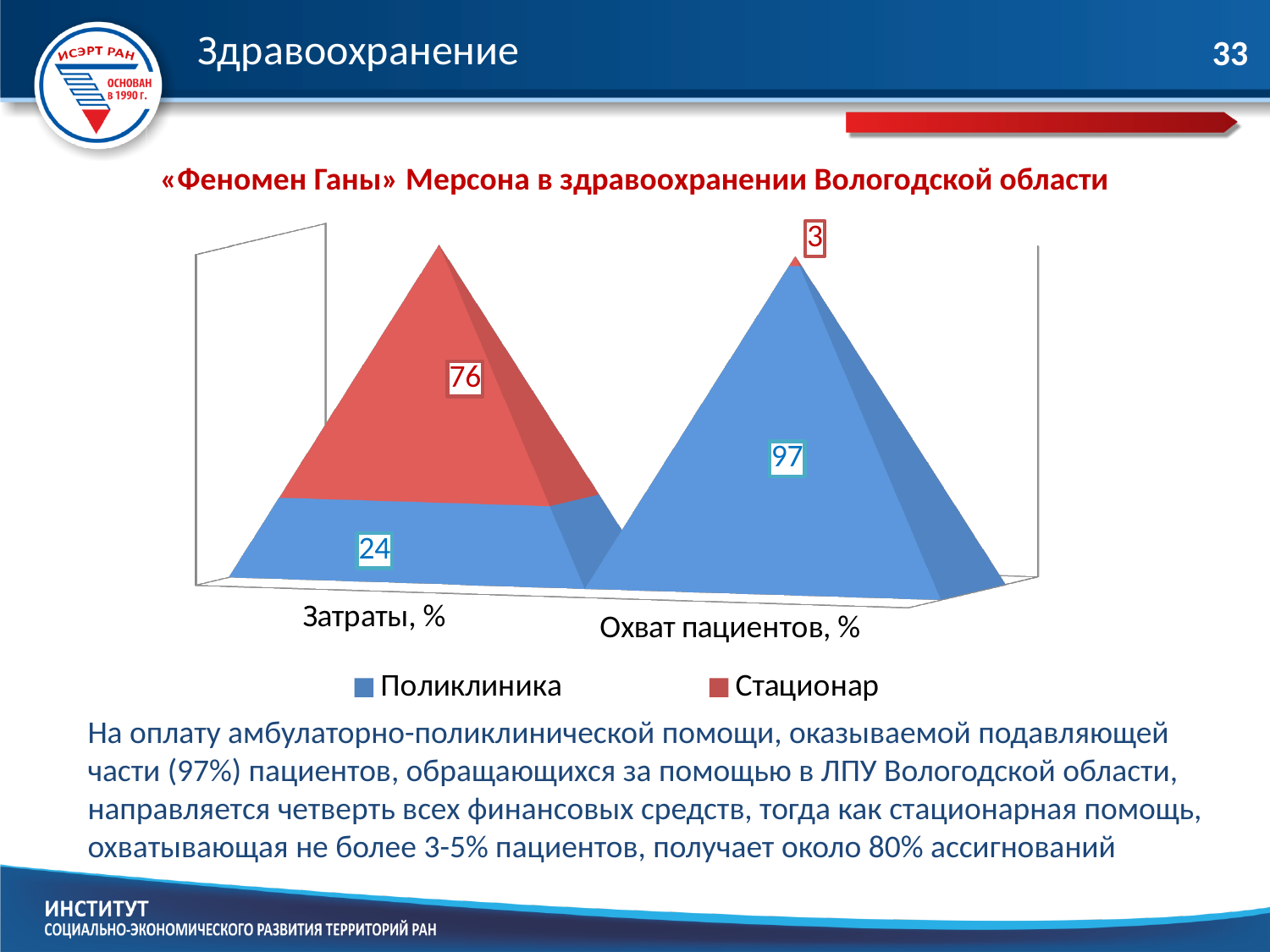
What is the value for Стационар in the Затраты, % category? 76 What is the difference between the Поликлиника and Стационар values in the Охват пациентов, % category? 94 Which series has the larger value in the Затраты, % category, Поликлиника or Стационар? Стационар What is the value for Поликлиника in the Охват пациентов, % category? 97 What is the total of the stacked bar for Охват пациентов, %? 100 What is the value for Поликлиника in the Затраты, % category? 24 Which series has the larger value in the Охват пациентов, % category, Поликлиника or Стационар? Поликлиника What is the value for Стационар in the Охват пациентов, % category? 3 How many categories are shown on the x axis of the chart? 2 How many series does the chart legend list? 2 Which colour represents the Стационар series in the chart? Red What is the difference between the Стационар and Поликлиника values in the Затраты, % category? 52